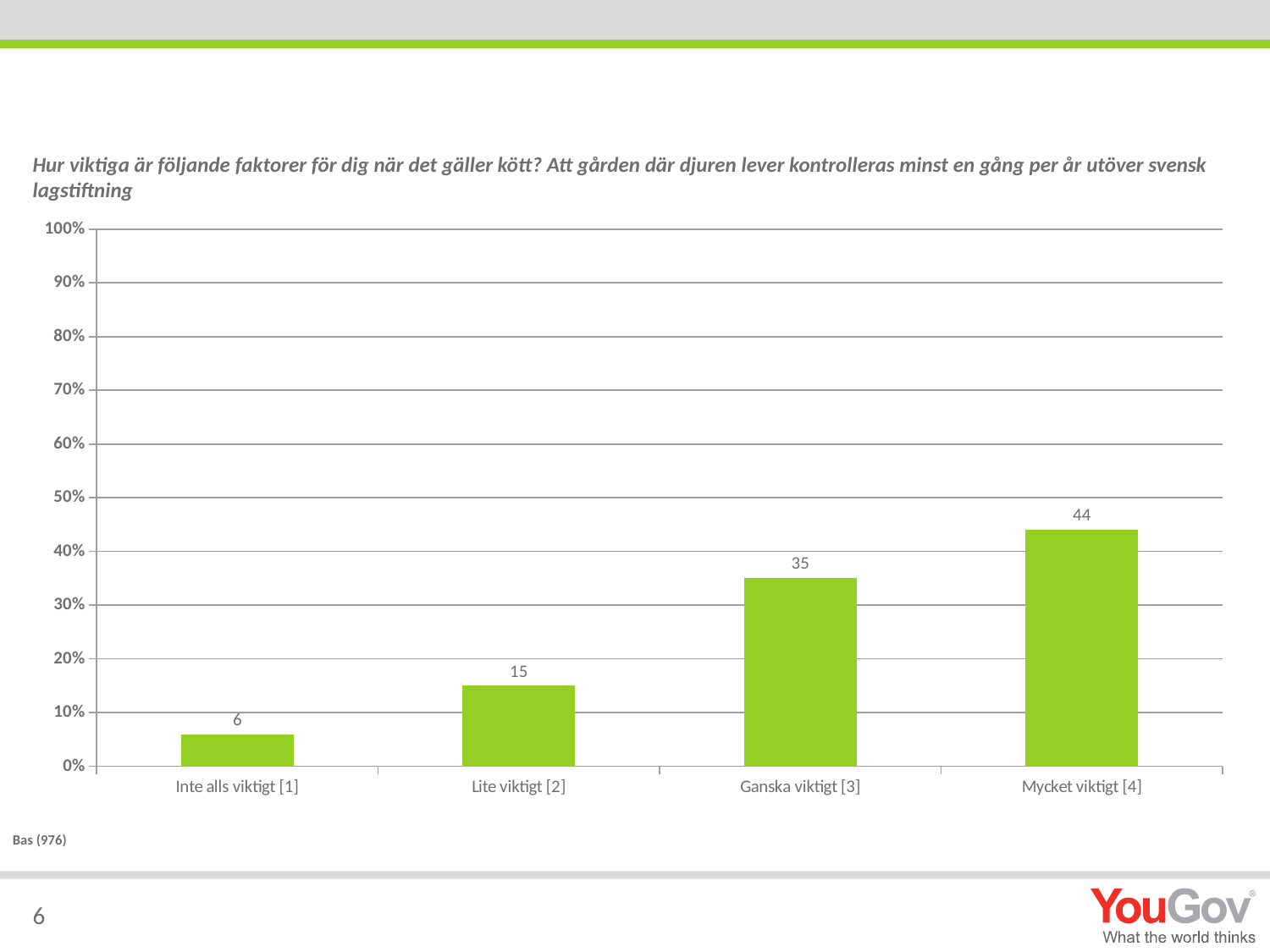
How many categories are shown on the x axis? 4 What is the difference between the values for "Mycket viktigt [4]" and "Ganska viktigt [3]"? 9 Which is larger, the value for "Lite viktigt [2]" or the value for "Ganska viktigt [3]"? Ganska viktigt [3] Do the values rise or fall from left to right along the x axis? rise Which category has the lowest value? Inte alls viktigt [1] What is the value for "Mycket viktigt [4]"? 44 Is the value for "Mycket viktigt [4]" greater or less than 50%? less What is the value for "Ganska viktigt [3]"? 35 What kind of chart is shown on the slide? bar chart What is the value for "Inte alls viktigt [1]"? 6 Which category has the highest value? Mycket viktigt [4] What is the value for "Lite viktigt [2]"? 15